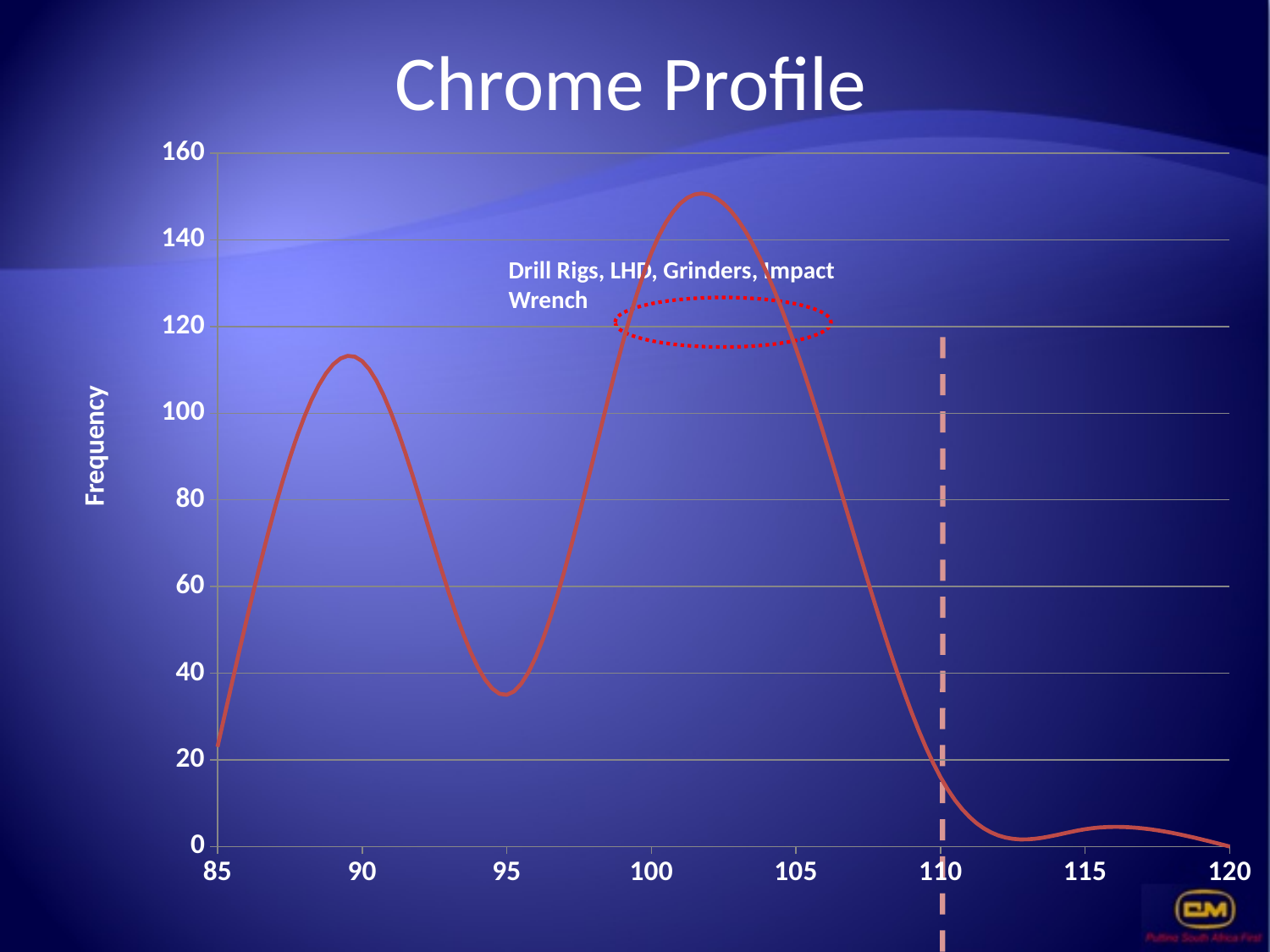
Is the value of the curve at 90 on the x axis greater or less than 100? greater What is the title of the chart? Chrome Profile Is the value of the curve at 95 on the x axis greater or less than 40? less What is the label on the vertical axis? Frequency Does the curve rise or fall between 95 and 100 on the x axis? rise What kind of chart is shown on the slide? line chart Does the curve rise or fall between 105 and 110 on the x axis? fall Is the value of the curve at 110 on the x axis greater or less than 40? less Which is higher: the peak of the curve near 90 or the peak near 102? the peak near 102